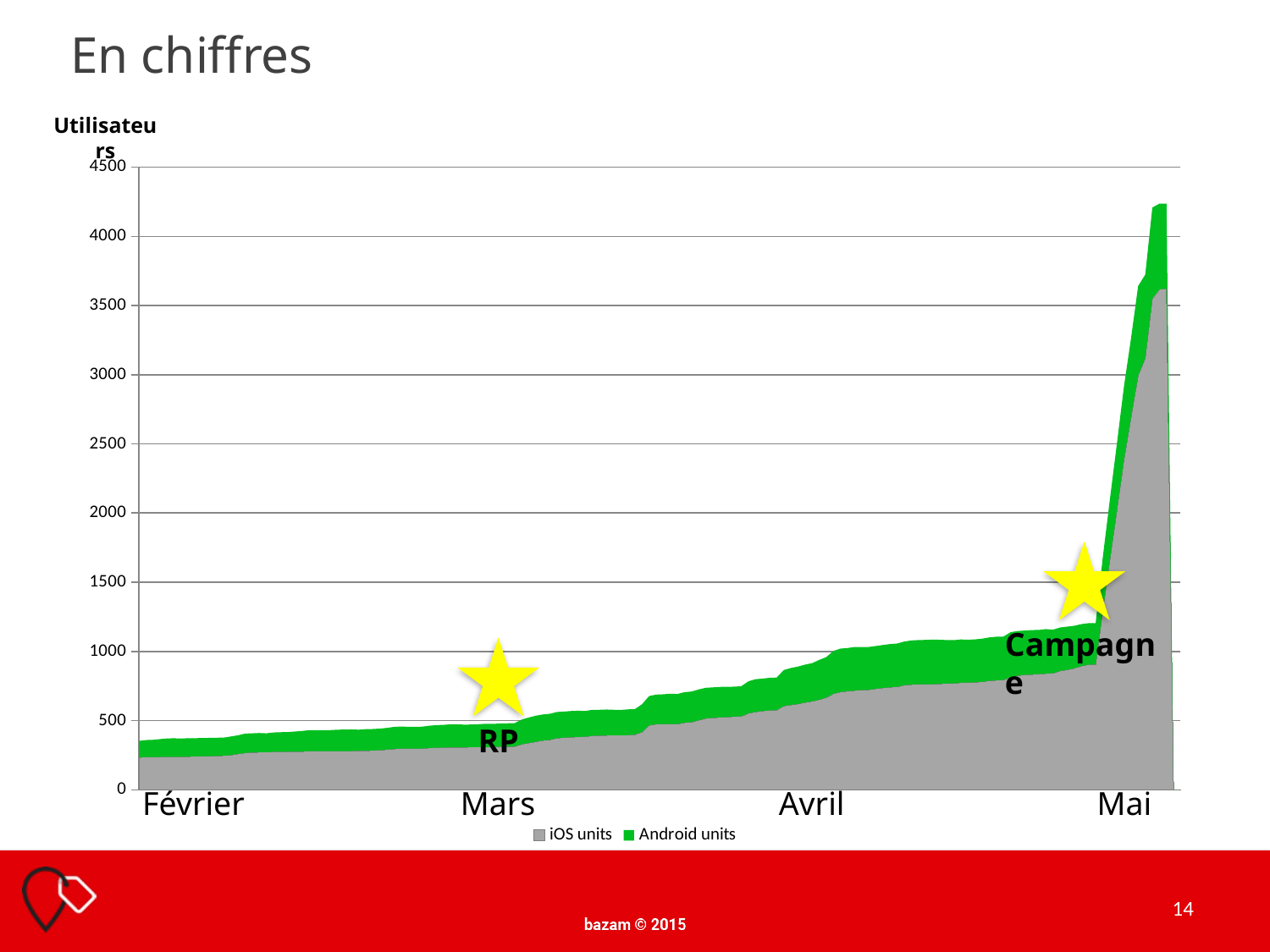
How many series does the legend list? 2 What are the two series named in the legend? iOS units and Android units Is the total value at the peak near Mai greater or less than 4000? greater What kind of chart is shown on the slide? Area chart Which month has the highest total number of users? Mai Which month has the lowest total number of users? Février Which colour represents Android units? Green Do the values rise or fall from Février to Mai? Rise Is the total value at the start of Février greater or less than 500? less How many month labels are shown on the x axis? 4 Is the iOS units value at the peak near Mai greater or less than 3000? greater Which is larger, the total value at Mai or the total value at Avril? Mai